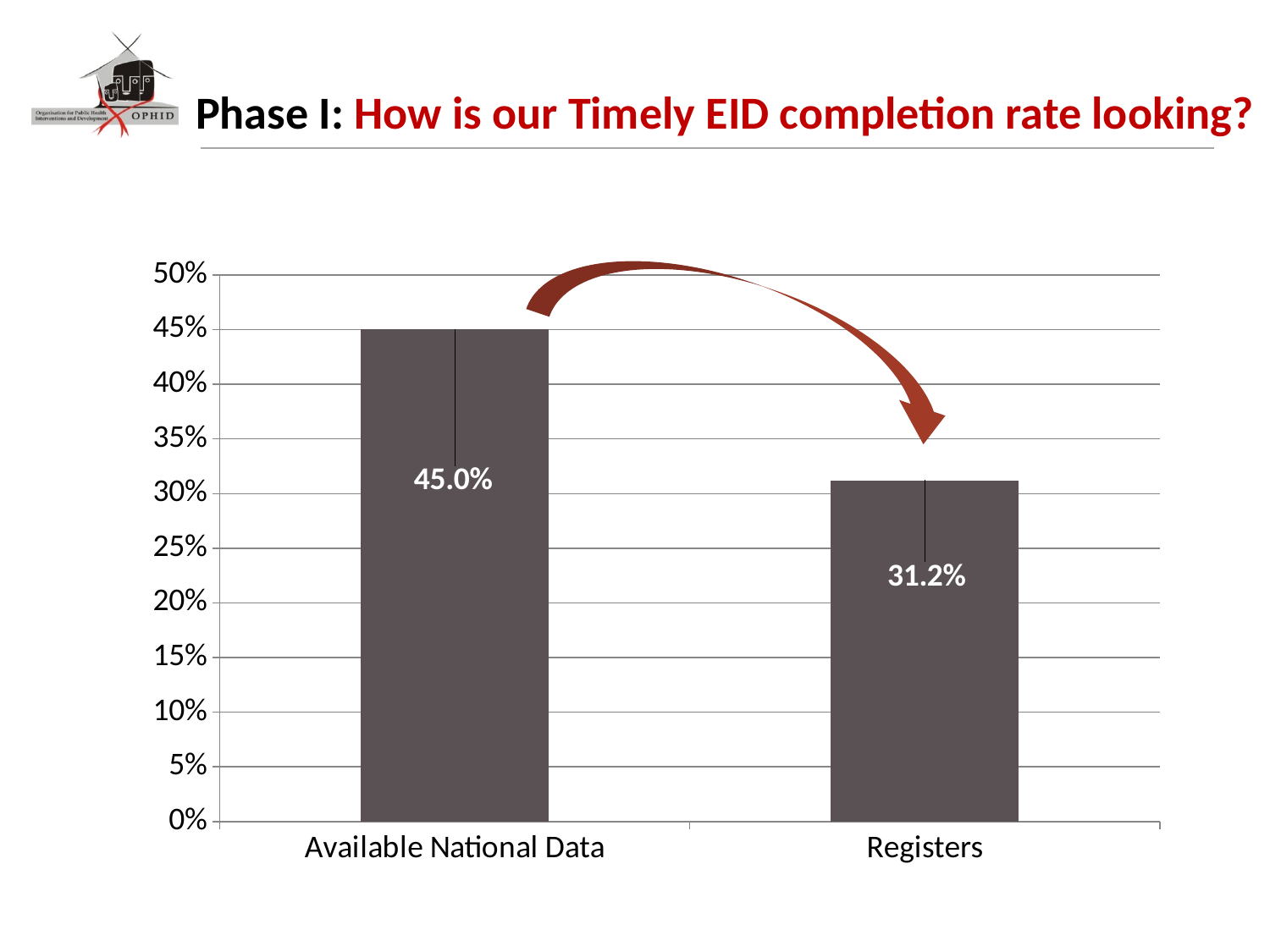
Is the value for Available National Data greater or less than 40%? greater What is the difference between the values for Available National Data and Registers? 13.8% Which category has the lowest value? Registers Do the values rise or fall from Available National Data to Registers? fall What is the value for Registers? 31.2% What kind of chart is shown on the slide? bar chart Which category has the highest value? Available National Data Which is larger, the value for Available National Data or the value for Registers? Available National Data What is the maximum value shown on the y axis? 50% How many categories are shown on the x axis? 2 What is the value for Available National Data? 45.0% Is the value for Registers greater or less than 35%? less